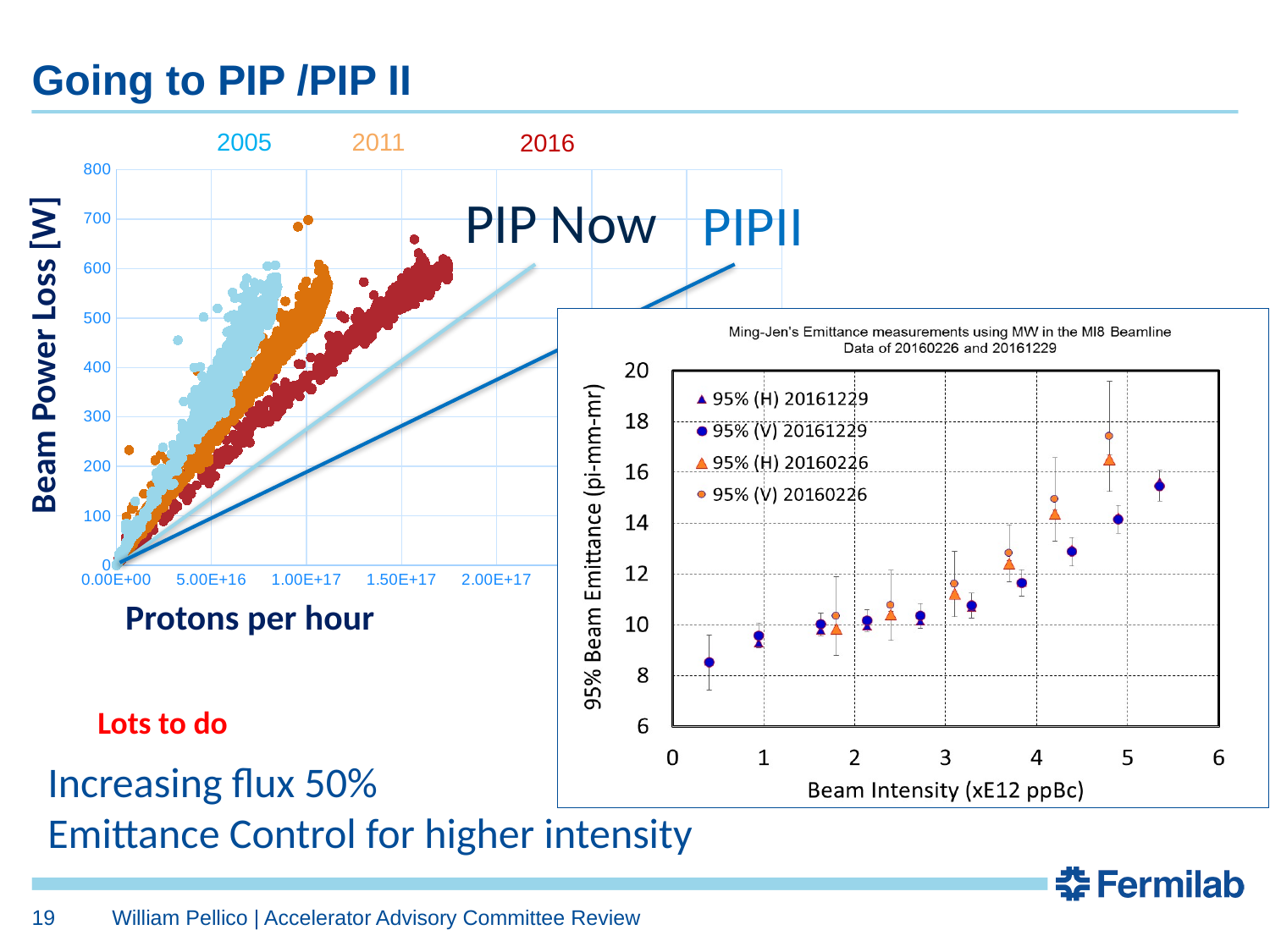
What kind of chart is the Beam Power Loss chart on the left of the slide? scatter chart How many years of data are plotted in the Beam Power Loss chart on the left? 3 In the emittance chart on the right, does 95% beam emittance rise or fall as beam intensity increases? rises In the emittance chart on the right, is the 95% (V) 20161229 emittance at the highest beam intensity (about 5.3) greater or less than 14? greater In the emittance chart on the right, what is the label of the horizontal axis? Beam Intensity (xE12 ppBc) How many series does the legend list in the emittance chart on the right? 4 In the emittance chart on the right, is the 95% (V) 20161229 emittance at the lowest beam intensity (about 0.4) greater or less than 10? less In the Beam Power Loss chart on the left, which year's data extends to the highest number of protons per hour? 2016 In the Beam Power Loss chart on the left, what is the label of the horizontal axis? Protons per hour In the Beam Power Loss chart on the left, does beam power loss rise or fall as protons per hour increases? rises In the Beam Power Loss chart on the left, what is the highest value shown on the vertical axis? 800 In the Beam Power Loss chart on the left, which year's data shows the highest beam power loss at 5.00E+16 protons per hour? 2005